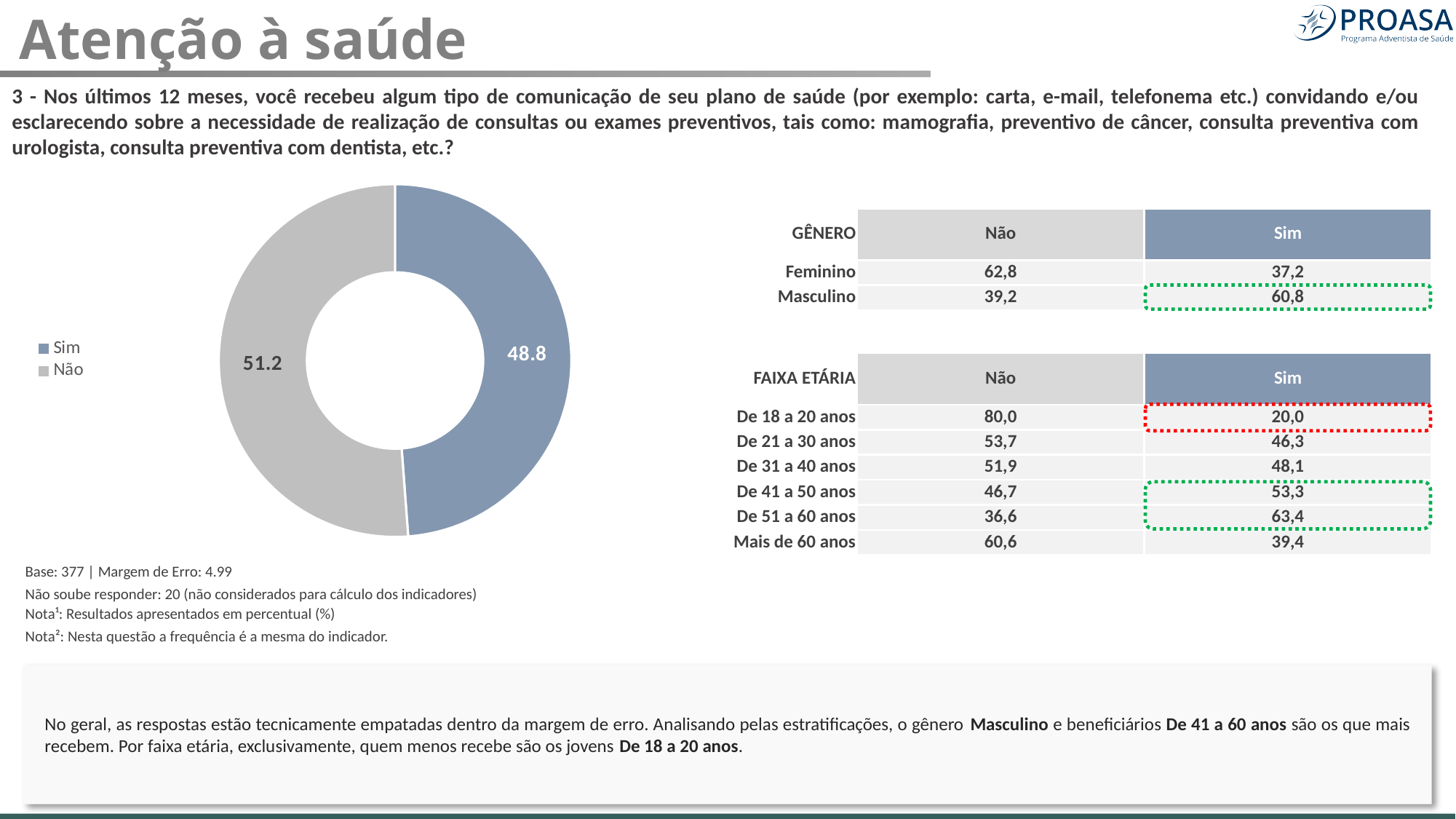
What kind of chart is shown on the left of the slide? pie chart (donut) What are the two legend entries of the donut chart? Sim and Não In the donut chart, what is the value shown for Não? 51.2 Which slice of the donut chart is the largest? Não Which slice of the donut chart is the smallest? Sim In the donut chart, what is the difference between the Não value and the Sim value? 2.4 What colour is the Sim slice in the donut chart? blue How many entries does the legend of the donut chart list? 2 How many slices does the donut chart have? 2 In the donut chart, what is the value shown for Sim? 48.8 In the donut chart, which is larger: Sim or Não? Não What share of the donut chart does the Não slice represent? 51.2